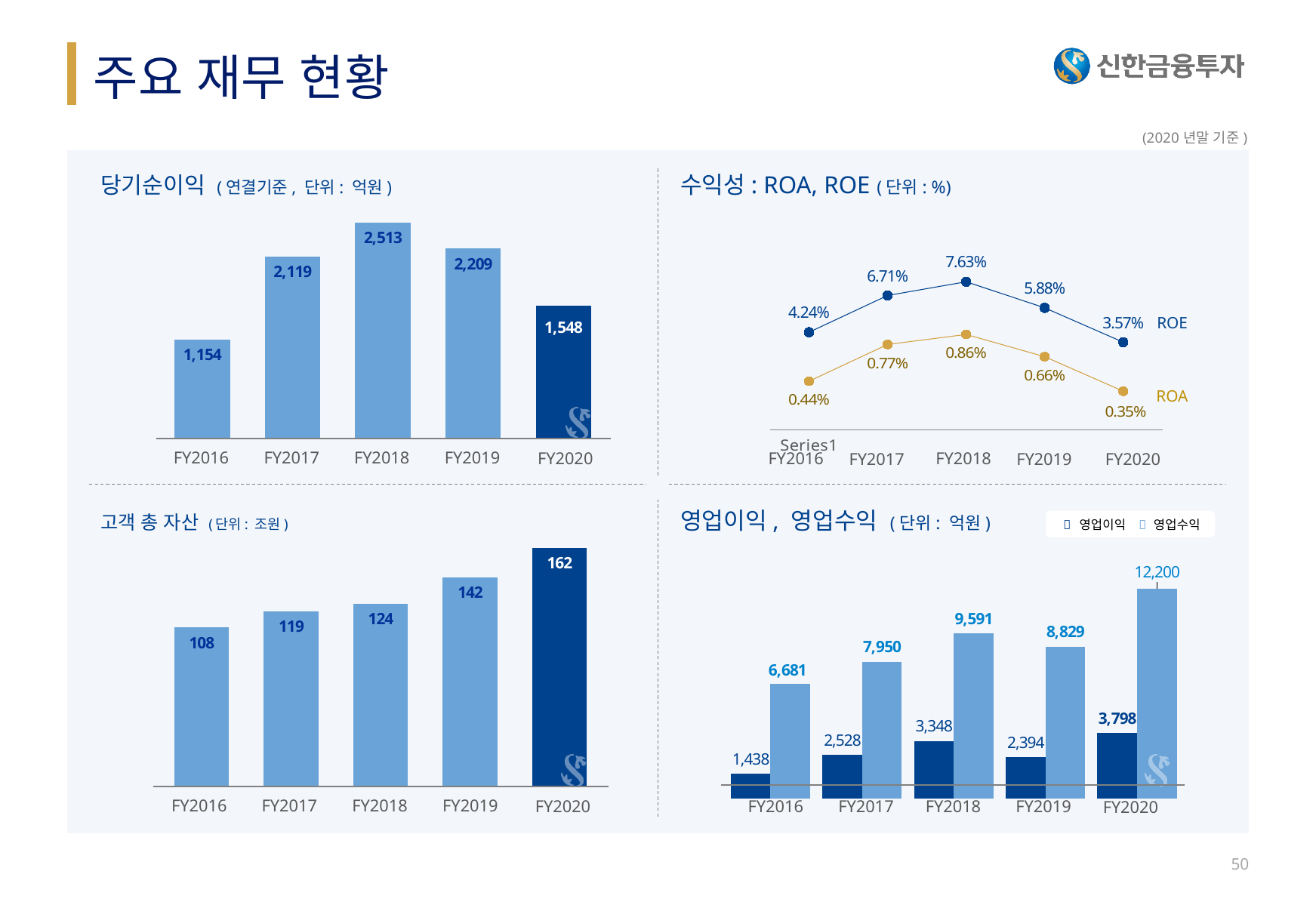
In the 영업이익, 영업수익 chart (bottom right), how many series does the legend list? 2 In the 당기순이익 chart (top left), what is the difference between FY2018 and FY2020? 965 In the 수익성 : ROA, ROE chart (top right), what is the ROE value for FY2018? 7.63% In the 고객 총 자산 chart (bottom left), how many fiscal years are shown? 5 In the 영업이익, 영업수익 chart (bottom right), what is the 영업수익 value for FY2020? 12,200 In the 당기순이익 chart (top left), what is the value for FY2018? 2,513 In the 영업이익, 영업수익 chart (bottom right), which is larger: 영업이익 for FY2018 or 영업이익 for FY2019? FY2018 In the 고객 총 자산 chart (bottom left), do the values rise or fall from FY2016 to FY2020? Rise In the 수익성 : ROA, ROE chart (top right), what is the ROA value for FY2020? 0.35% In the 수익성 : ROA, ROE chart (top right), what kind of chart is shown? Line chart In the 고객 총 자산 chart (bottom left), what is the value for FY2019? 142 In the 당기순이익 chart (top left), which fiscal year has the lowest value? FY2016